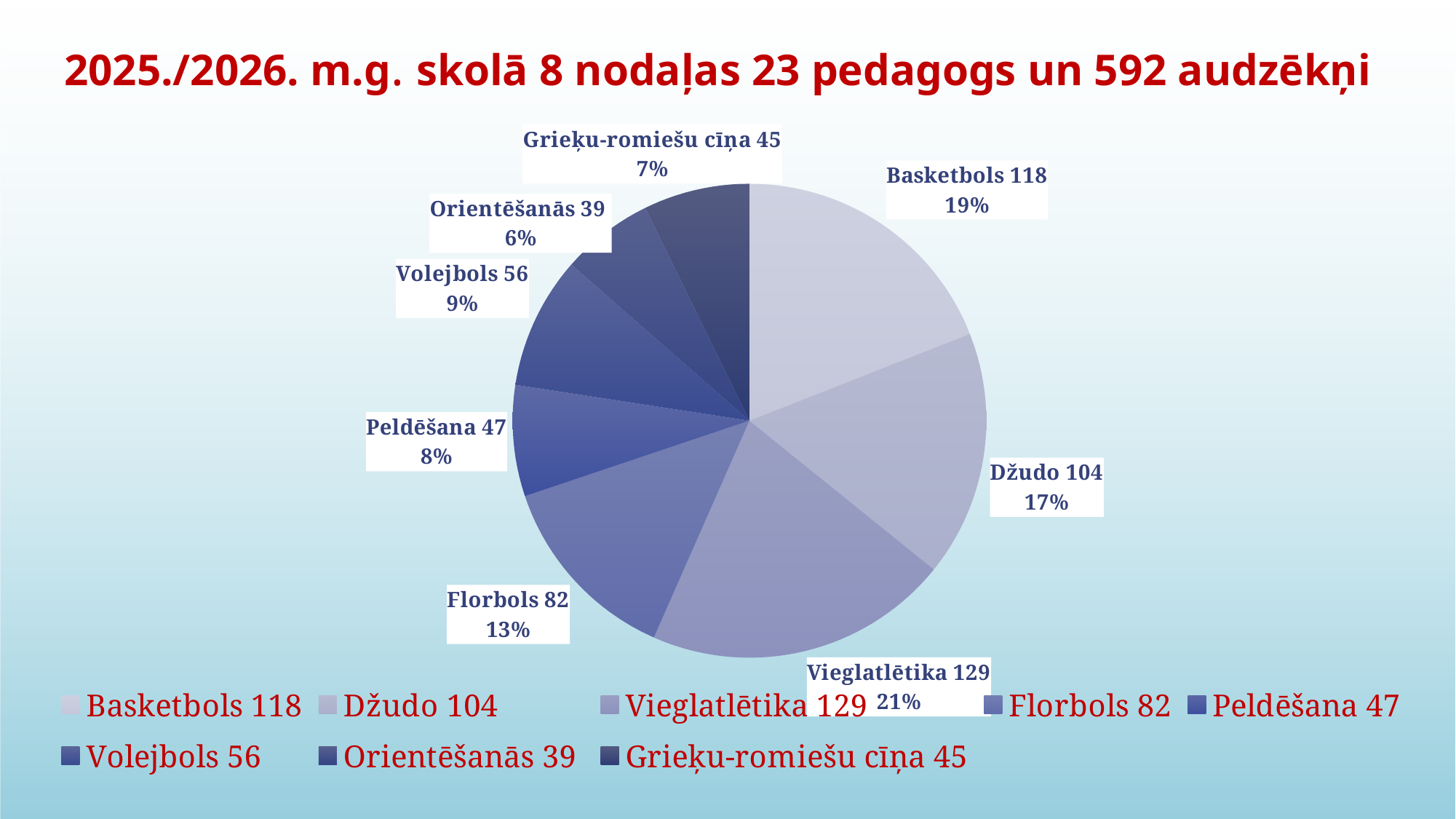
What kind of chart is shown on the slide? pie chart Which category has the smallest slice? Orientēšanās What is the difference between the values for Basketbols and Džudo? 14 How many slices does the pie chart have? 8 What percentage share does the Florbols slice have? 13% How many entries does the legend list? 8 Which category has the largest slice? Vieglatlētika Which is larger, the value for Volejbols or the value for Grieķu-romiešu cīņa? Volejbols What is the value shown for Peldēšana? 47 What percentage share does the Orientēšanās slice have? 6% What is the total of all the values shown in the pie chart? 620 What is the value shown for Vieglatlētika? 129